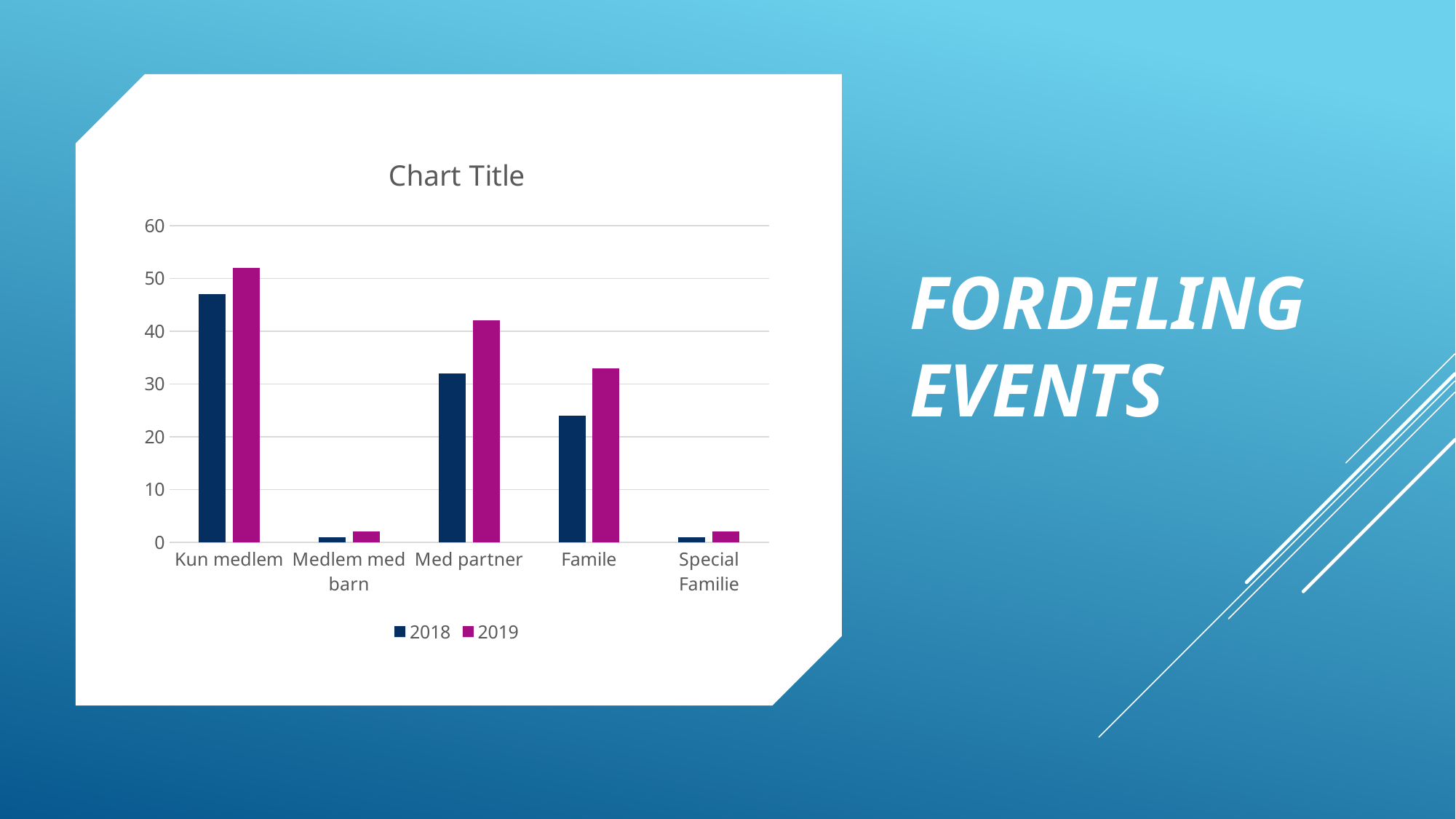
How many categories are shown on the x axis of the chart? 5 Which category has the highest value for the 2019 series? Kun medlem Is the 2019 value for Special Familie greater or less than 10? less Is the 2019 value for Medlem med barn greater or less than 10? less Which is larger for the 2018 series: Kun medlem or Med partner? Kun medlem Is the 2018 value for Famile greater or less than 30? less Which category has the highest value for the 2018 series? Kun medlem What are the two series named in the chart's legend? 2018 and 2019 How many series does the chart's legend list? 2 What kind of chart is shown on the slide? bar chart Which is larger for the 2019 series: Med partner or Famile? Med partner